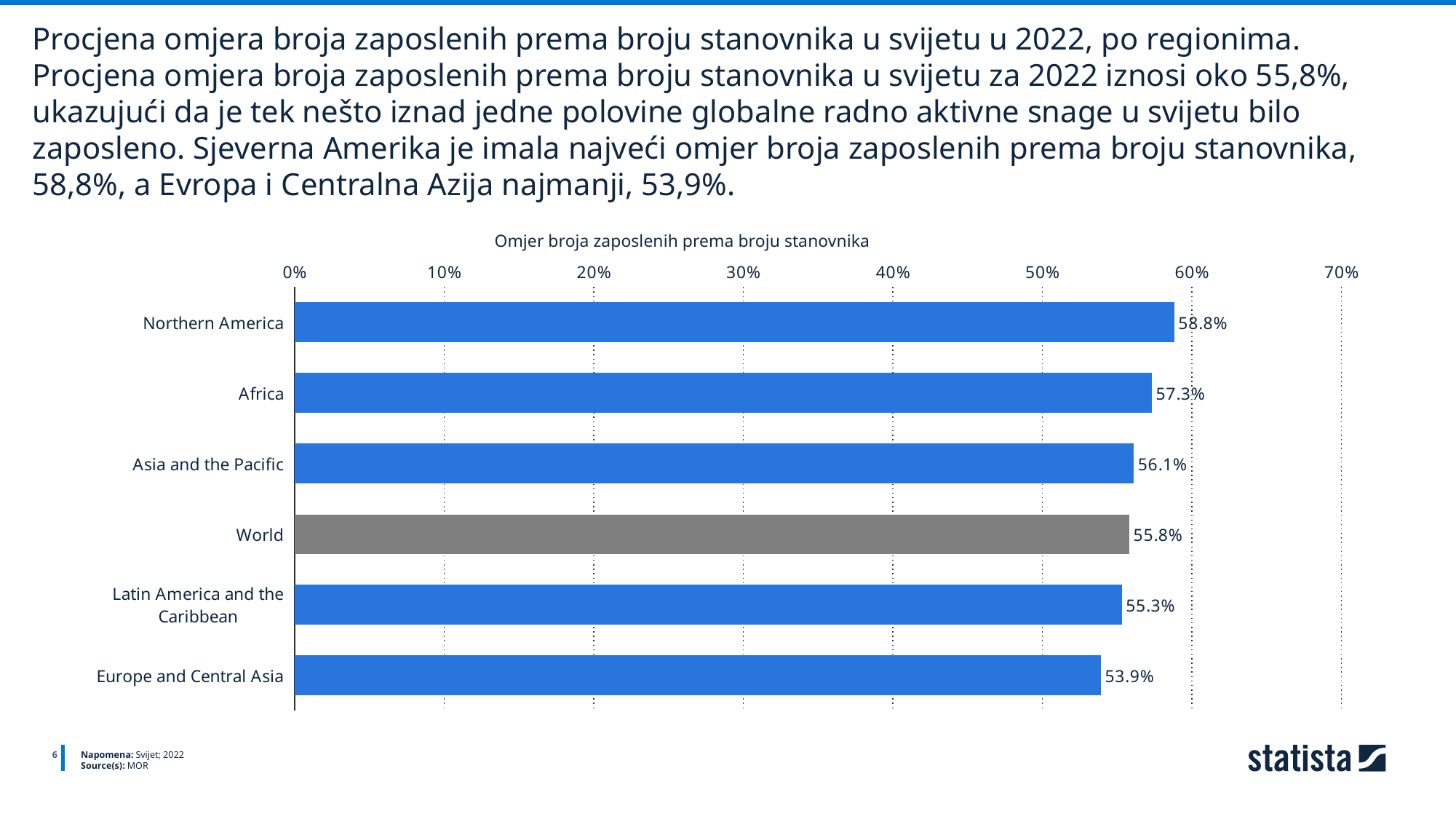
Which is larger, the value for Asia and the Pacific or the value for World? Asia and the Pacific Which region has the lowest employment-to-population ratio? Europe and Central Asia What is the value shown for World? 55.8% What kind of chart is shown on the slide? Bar chart Which bar is coloured grey instead of blue? World What is the employment-to-population ratio shown for Northern America? 58.8% How many categories are shown in the chart? 6 What is the difference between the values for Northern America and Europe and Central Asia? 4.9% What value is shown for Latin America and the Caribbean? 55.3% What value is shown for Africa? 57.3% What is the difference between the values for Africa and Asia and the Pacific? 1.2% Which region has the highest employment-to-population ratio? Northern America